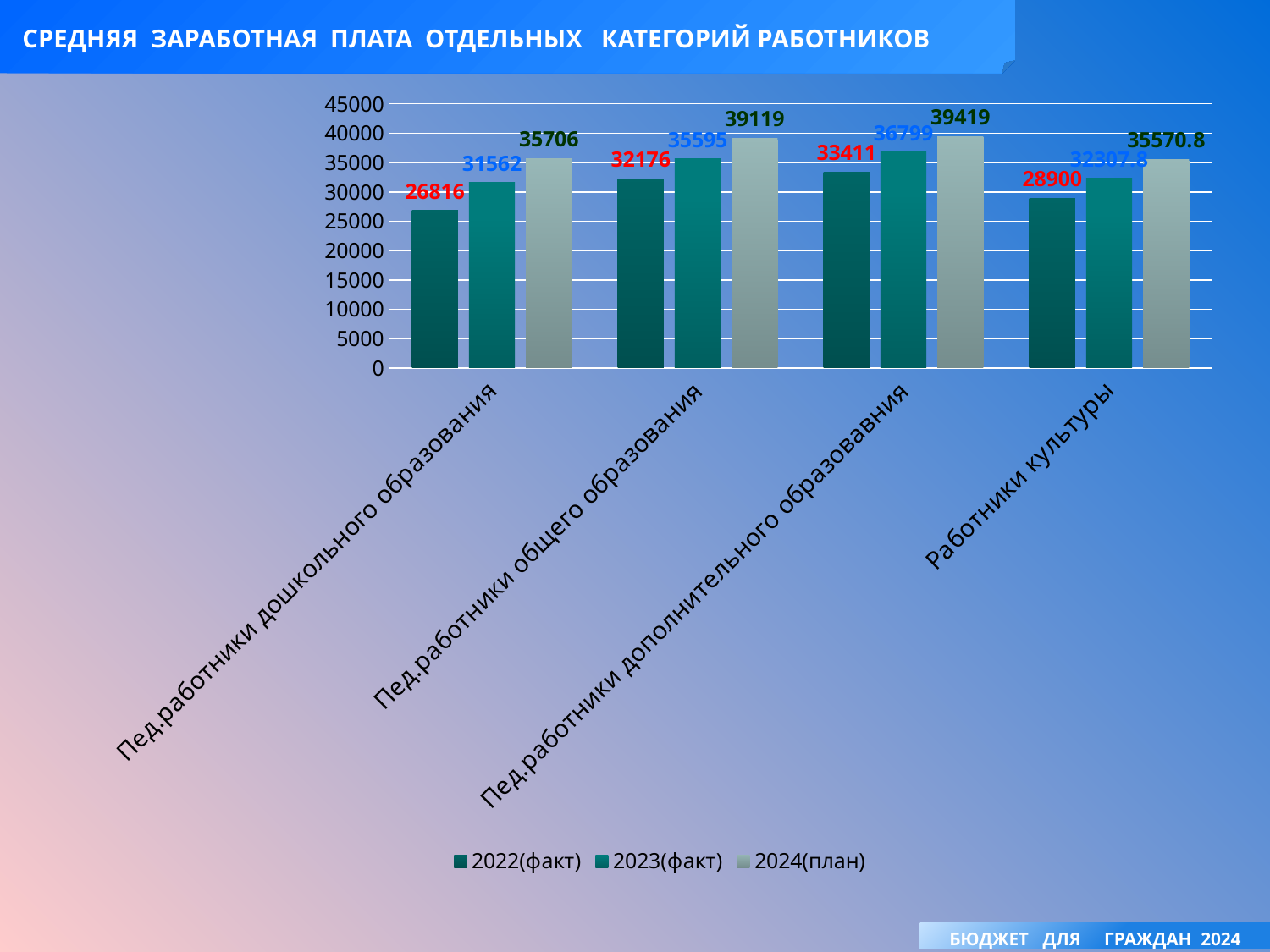
What is the 2022(факт) value for Пед.работники дошкольного образования? 26816 What type of chart is shown on the slide? bar chart Is the 2022(факт) value for Пед.работники дополнительного образовавния greater or less than 30000? greater Which category has the highest 2024(план) value? Пед.работники дополнительного образовавния Which category has the lowest 2022(факт) value? Пед.работники дошкольного образования What is the 2024(план) value for Работники культуры? 35570.8 How many categories of workers are shown on the x axis? 4 What is the 2024(план) value for Пед.работники общего образования? 39119 Which is larger: the 2023(факт) value for Пед.работники общего образования or the 2023(факт) value for Пед.работники дошкольного образования? Пед.работники общего образования How many series does the legend list? 3 What is the 2022(факт) value for Работники культуры? 28900 What is the difference between the 2024(план) and 2022(факт) values for Пед.работники дошкольного образования? 8890